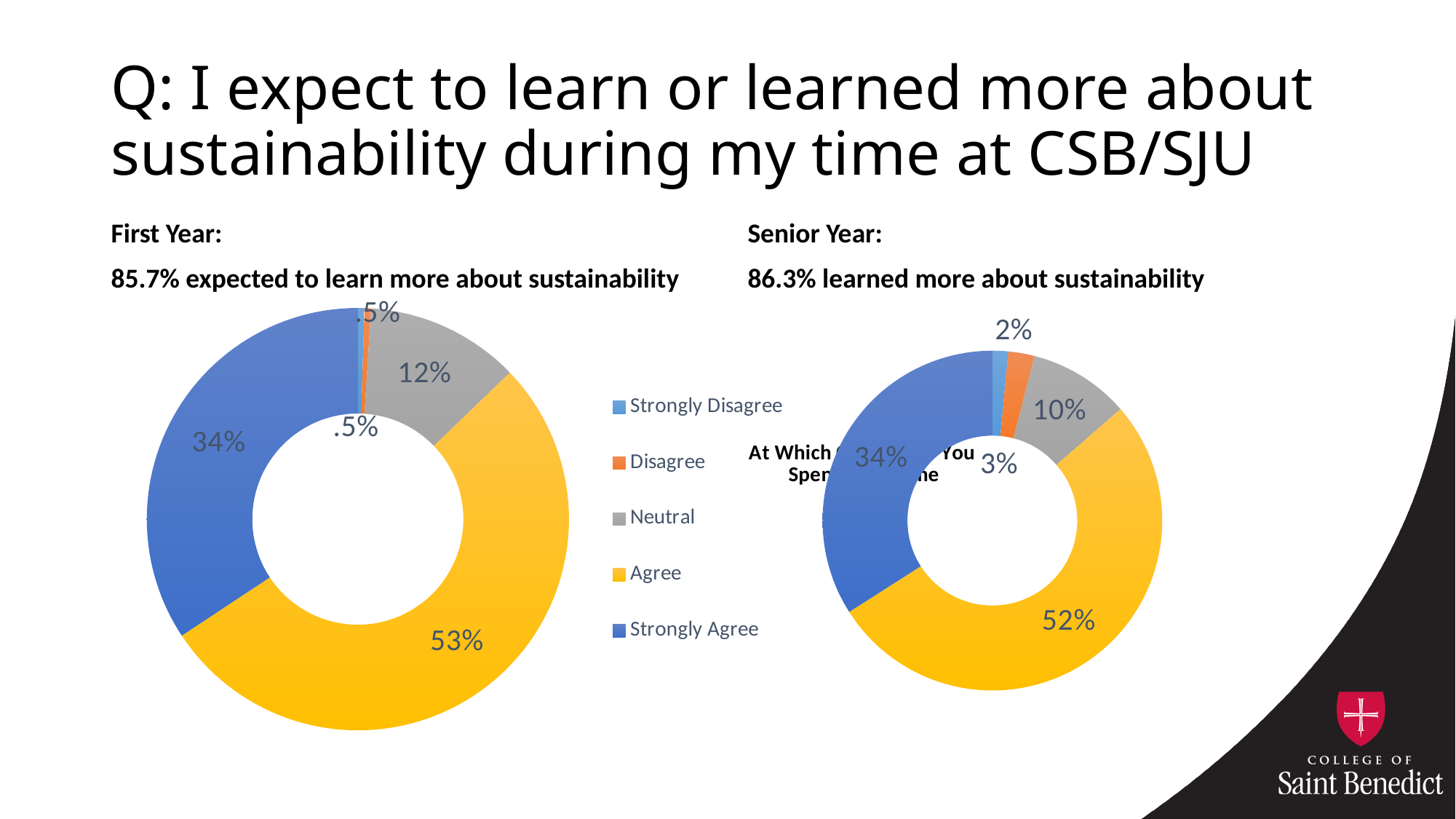
Which colour represents Strongly Agree in the legend? Blue In the Senior Year chart, which is larger: the Neutral share or the Disagree share? Neutral In the First Year chart, which response category has the largest share? Agree In the First Year chart, what percentage of respondents chose Agree? 53% What type of chart is used to show the First Year responses? Doughnut chart In the Senior Year chart, what percentage of respondents chose Strongly Agree? 34% How many response categories does the legend list? 5 In the Senior Year chart, which response category has the largest share? Agree In the Senior Year chart, which response category has the smallest share? Strongly Disagree In the Senior Year chart, what percentage of respondents chose Neutral? 10% In the First Year chart, what percentage of respondents chose Neutral? 12% What is the difference between the Agree share in the First Year chart and the Agree share in the Senior Year chart? 1%